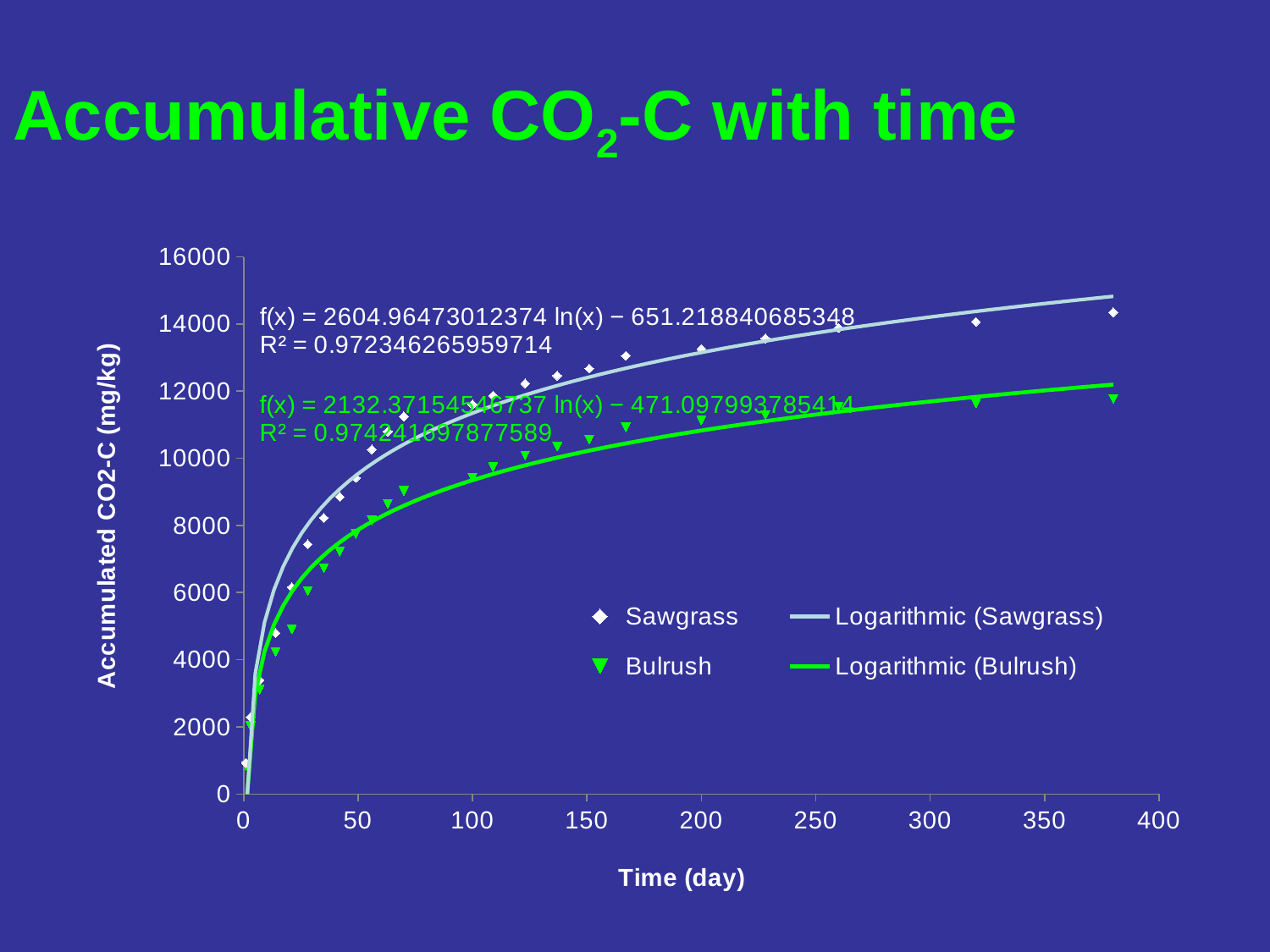
Do the accumulated CO2-C values rise or fall as time increases? Rise What is the label of the x axis? Time (day) Which series reaches higher accumulated CO2-C values, Sawgrass or Bulrush? Sawgrass Is the Sawgrass value at about day 380 greater or less than 12000 mg/kg? greater How many entries does the chart legend list? 4 Is the Bulrush value at about day 50 greater or less than 10000 mg/kg? less What kind of chart is shown on the slide? Scatter chart Is the Bulrush value at about day 380 greater or less than 10000 mg/kg? greater What is the maximum value shown on the y axis? 16000 What is the R² value shown for the Sawgrass logarithmic fit? 0.972346265959714 What is the R² value shown for the Bulrush logarithmic fit? 0.974241697877589